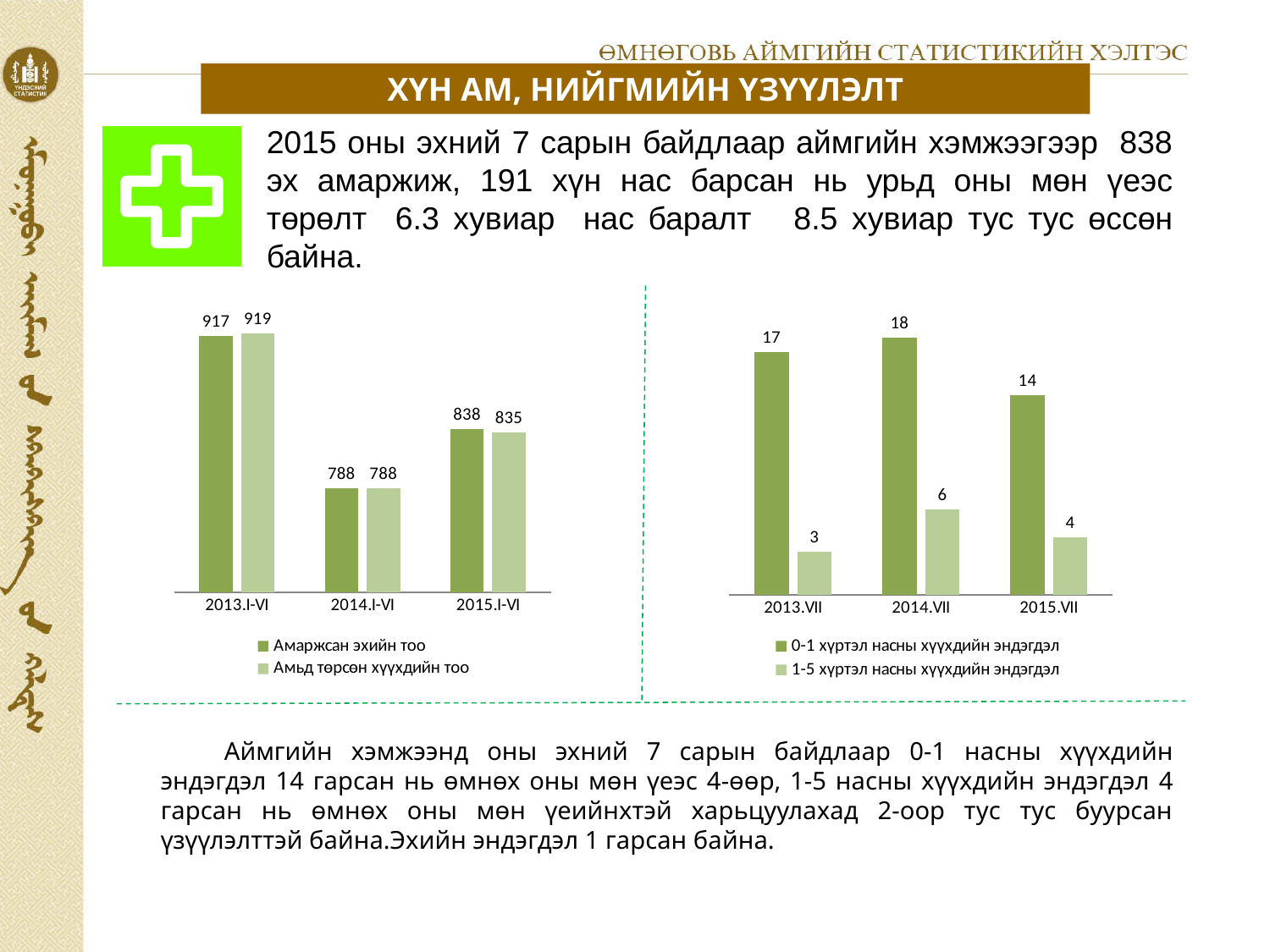
In the right chart, what is the difference between 0-1 хүртэл насны хүүхдийн эндэгдэл and 1-5 хүртэл насны хүүхдийн эндэгдэл in 2015.VII? 10 In the right chart, is the value of 0-1 хүртэл насны хүүхдийн эндэгдэл larger in 2013.VII or 2015.VII? 2013.VII In the left chart, what is the value of Амаржсан эхийн тоо for 2013.I-VI? 917 In the left chart, what is the difference between Амаржсан эхийн тоо in 2013.I-VI and 2014.I-VI? 129 In the right chart, what is the value of 1-5 хүртэл насны хүүхдийн эндэгдэл for 2013.VII? 3 In the right chart, what is the value of 0-1 хүртэл насны хүүхдийн эндэгдэл for 2014.VII? 18 In the left chart, what is the value of Амьд төрсөн хүүхдийн тоо for 2015.I-VI? 835 What kind of chart is the left chart? Bar chart In the left chart, how many series does the legend list? 2 In the right chart, how many periods are shown on the x axis? 3 In the left chart, which period has the lowest value for Амаржсан эхийн тоо? 2014.I-VI In the right chart, which period has the highest value for 1-5 хүртэл насны хүүхдийн эндэгдэл? 2014.VII